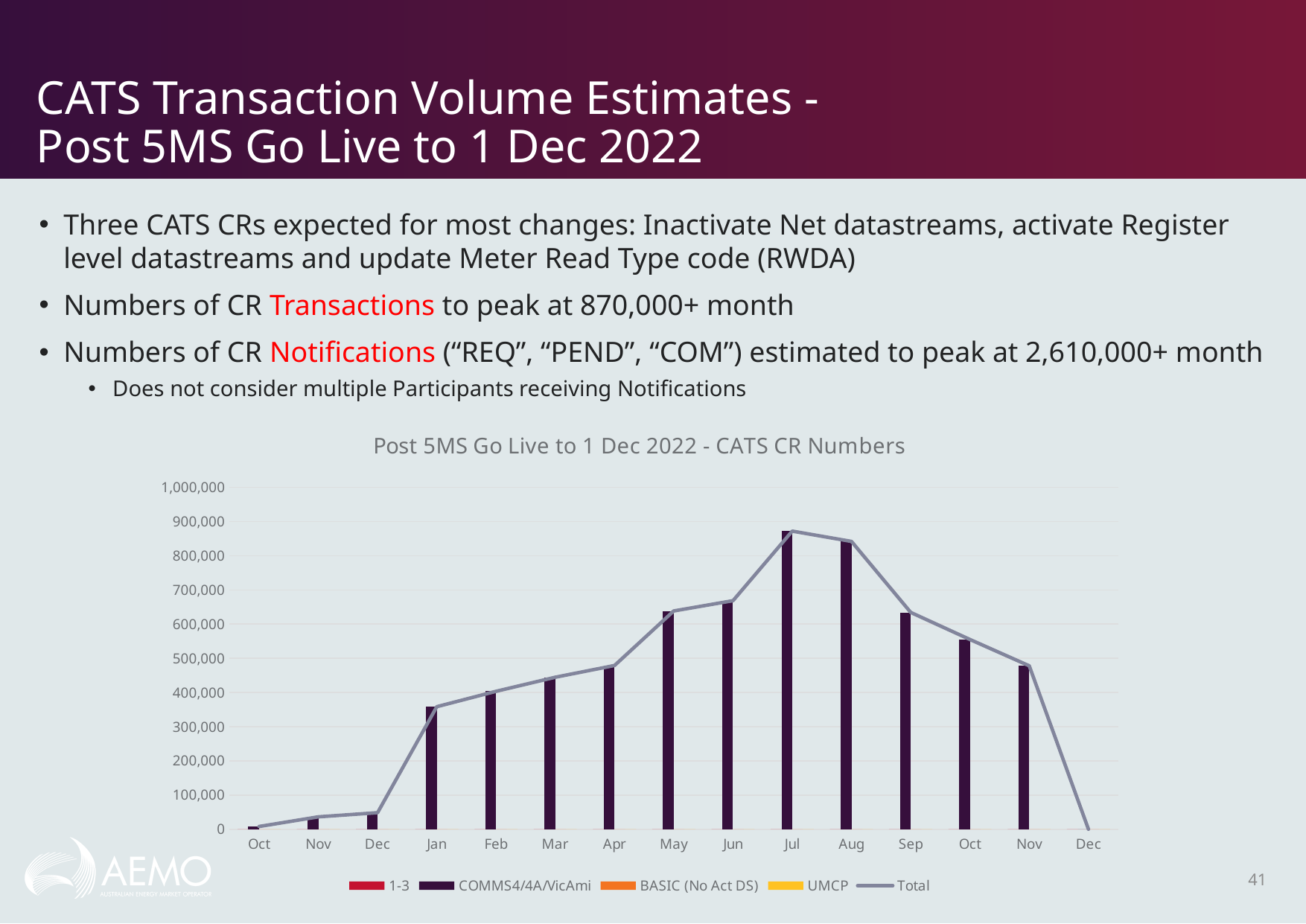
In which month does the Total line reach its highest value? Jul Which series makes up almost all of the visible bar height in the chart? COMMS4/4A/VicAmi How many series does the chart legend list? 5 Does the Total line rise or fall from Jan to Jul? Rises What is the title of the chart? Post 5MS Go Live to 1 Dec 2022 - CATS CR Numbers Is the Total value for Sep greater or less than 600,000? greater How many months are shown along the x axis of the chart? 15 Is the Total value for Feb greater or less than 500,000? less Is the Total value for Jan greater or less than 300,000? greater Which month has the larger Total value, Sep or Oct (the second Oct)? Sep What kind of chart is shown on the slide? A combined bar and line chart